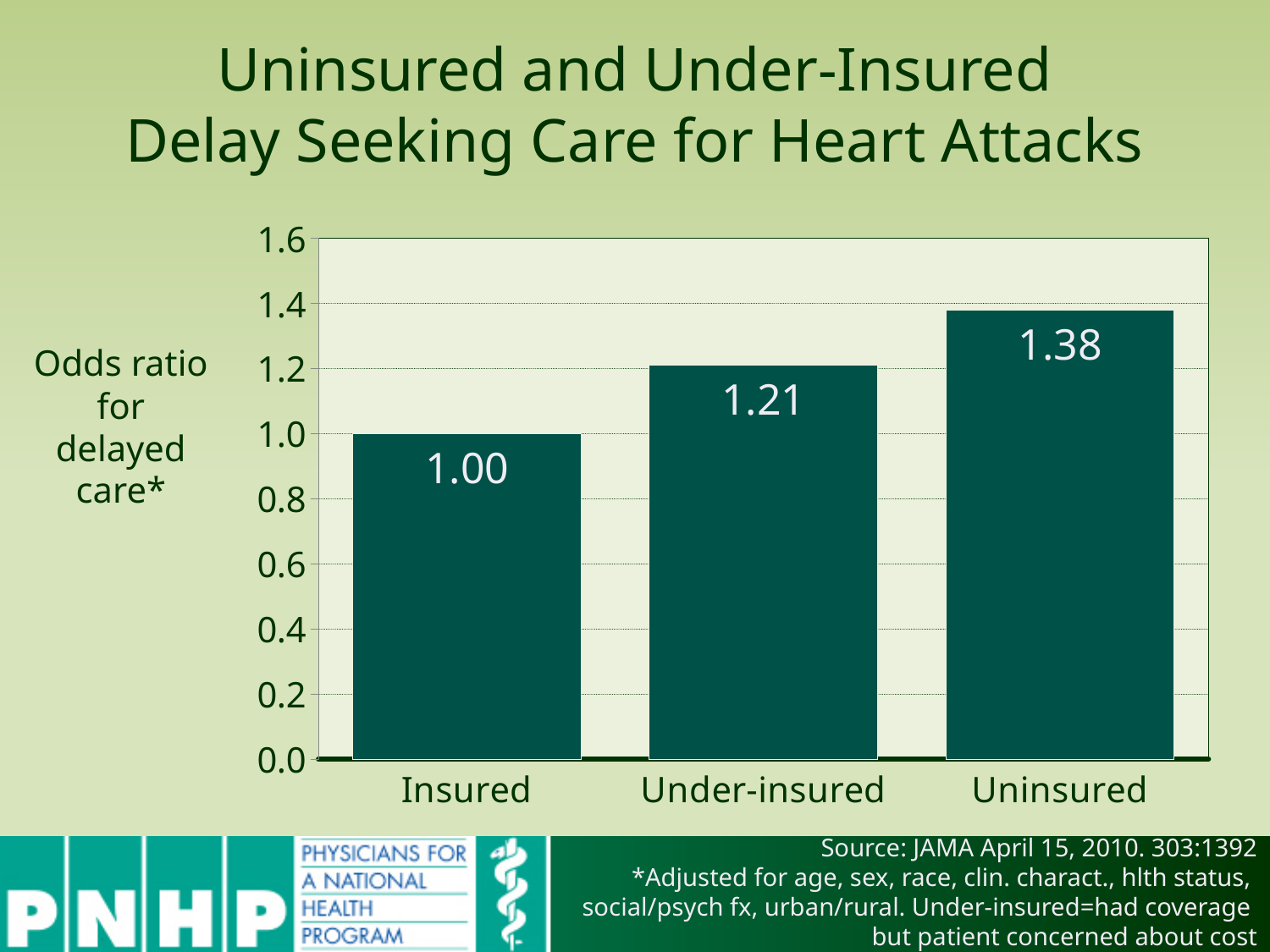
Which group has the highest odds ratio for delayed care? Uninsured What is the odds ratio for delayed care for the Uninsured group? 1.38 What type of chart is shown on the slide? Bar chart Which group has the lowest odds ratio for delayed care? Insured What is the odds ratio for delayed care for the Under-insured group? 1.21 What is the difference between the odds ratios for the Uninsured and Insured groups? 0.38 What is the difference between the odds ratios for the Uninsured and Under-insured groups? 0.17 How many groups are shown on the chart? 3 What is the odds ratio for delayed care for the Insured group? 1.00 Which group has a larger odds ratio for delayed care, Under-insured or Insured? Under-insured Do the odds ratios rise or fall moving from Insured to Uninsured along the x axis? Rise Is the odds ratio for the Uninsured group greater or less than 1.2? greater